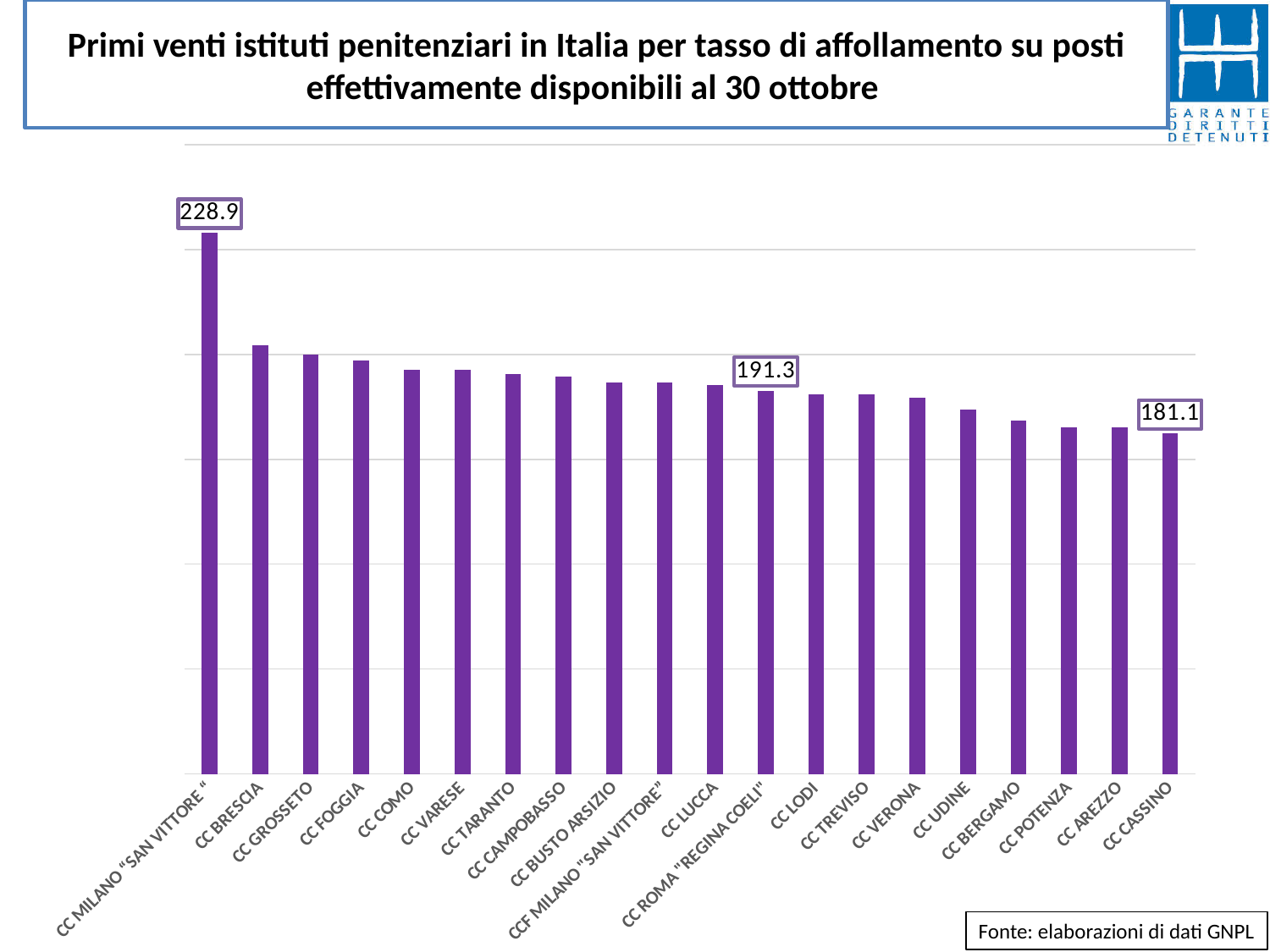
Do the values rise or fall from left to right along the x axis? fall What is the value for CC MILANO "SAN VITTORE"? 228.9 Which institute has the highest value? CC MILANO "SAN VITTORE" What is the difference between the values for CC ROMA "REGINA COELI" and CC CASSINO? 10.2 Which institute has the lowest value? CC CASSINO Which is larger, the value for CC FOGGIA or the value for CC BERGAMO? CC FOGGIA What kind of chart is shown on the slide? bar chart Which is larger, the value for CC BRESCIA or the value for CC UDINE? CC BRESCIA What is the value for CC ROMA "REGINA COELI"? 191.3 What is the difference between the values for CC MILANO "SAN VITTORE" and CC CASSINO? 47.8 How many institutes are shown in the chart? 20 What is the value for CC CASSINO? 181.1